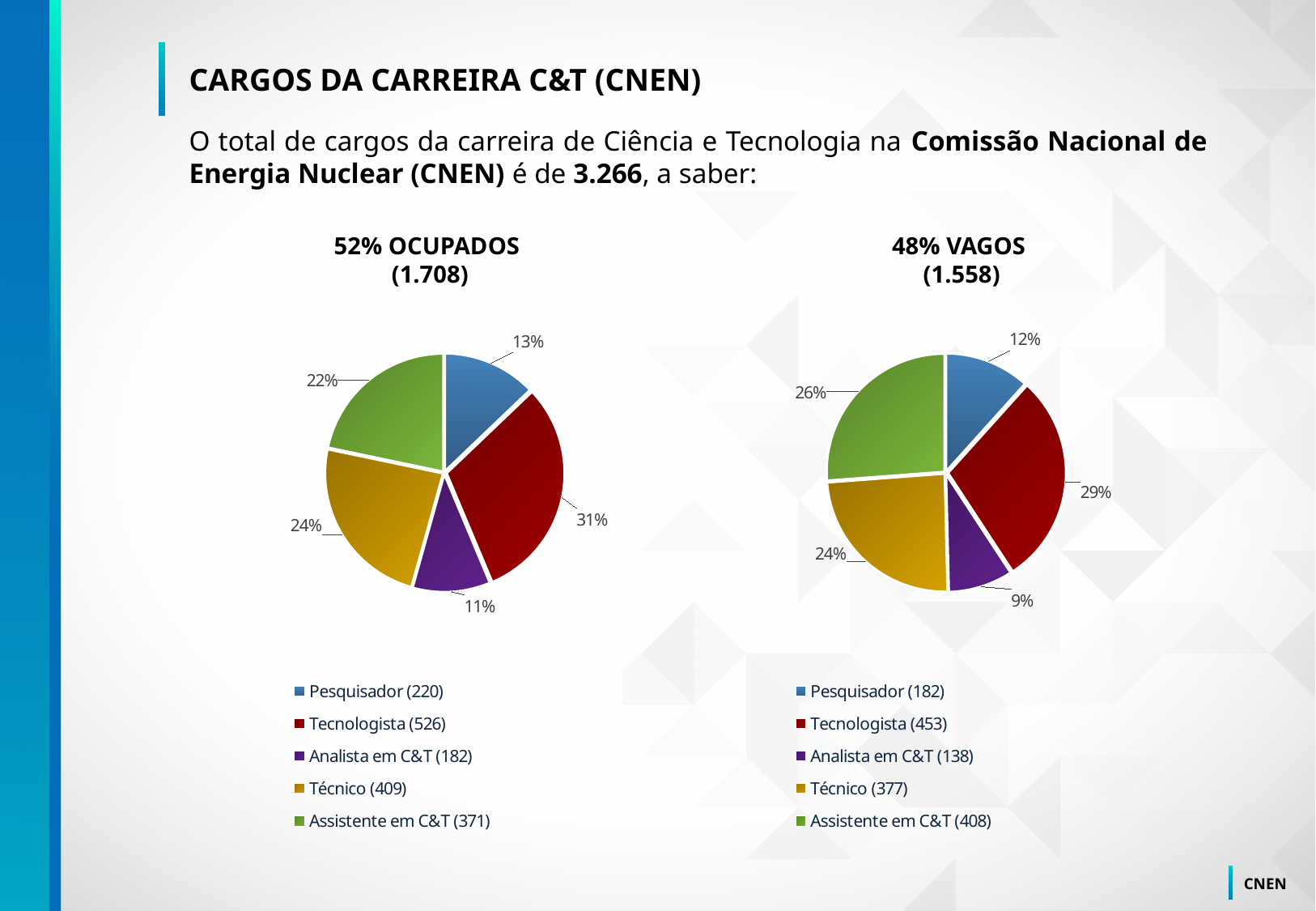
In the '48% VAGOS (1.558)' chart, which category has the smallest slice? Analista em C&T What colour is the Assistente em C&T slice in the '52% OCUPADOS (1.708)' chart? Green How many slices does the '52% OCUPADOS (1.708)' pie chart have? 5 In the '52% OCUPADOS (1.708)' chart, which category has the largest slice? Tecnologista In the '52% OCUPADOS (1.708)' chart, what share of the pie does Tecnologista represent? 31% In the '48% VAGOS (1.558)' chart, which is larger: the Técnico slice or the Pesquisador slice? Técnico What type of chart is used for '48% VAGOS (1.558)'? Pie chart In the '52% OCUPADOS (1.708)' chart, what is the difference in percentage points between the Tecnologista slice and the Analista em C&T slice? 20 In the '52% OCUPADOS (1.708)' chart, what is the number shown in the legend for Técnico? 409 In the '48% VAGOS (1.558)' chart, what is the number shown in the legend for Analista em C&T? 138 In the '48% VAGOS (1.558)' chart, what is the difference between the legend values for Tecnologista and Técnico? 76 In the '48% VAGOS (1.558)' chart, what share of the pie does Assistente em C&T represent? 26%